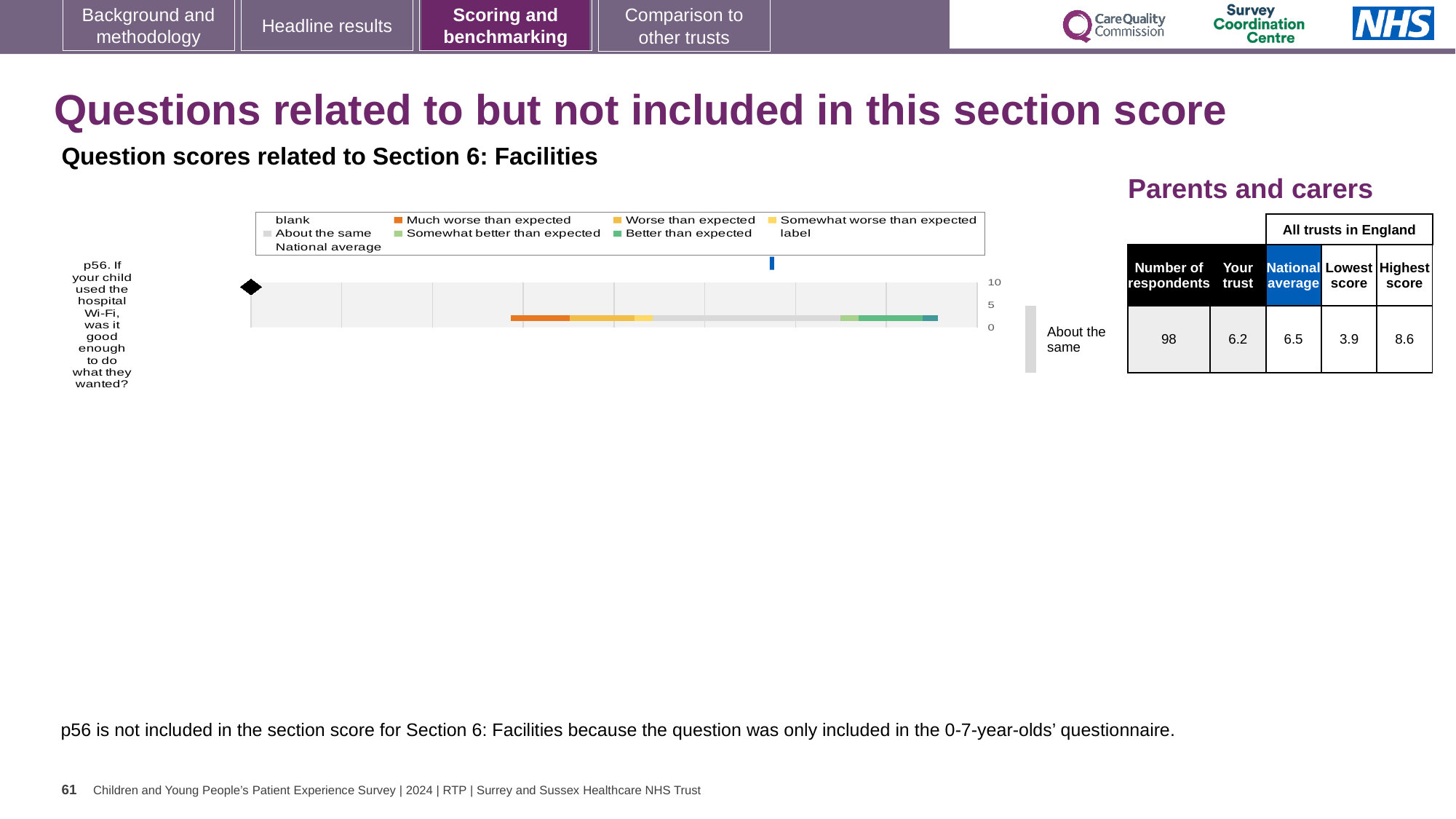
What kind of chart is shown for question p56? bar chart How many questions (categories) are plotted in the chart? 1 According to the table beside the chart, how many respondents answered p56? 98 Which benchmarking category is the trust's p56 score placed in, as labelled next to the chart? About the same What is the highest tick value shown on the chart's score axis? 10 According to the table beside the chart, what is the lowest score among all trusts in England for p56? 3.9 According to the table beside the chart, what is the highest score among all trusts in England for p56? 8.6 Which question number is plotted in the chart? p56 For p56, which is larger: the 'Your trust' score or the national average? National average According to the table beside the chart, what is the national average score for p56? 6.5 According to the table beside the chart, what is the 'Your trust' score for p56? 6.2 What is the difference between the highest score (8.6) and the lowest score (3.9) for p56? 4.7